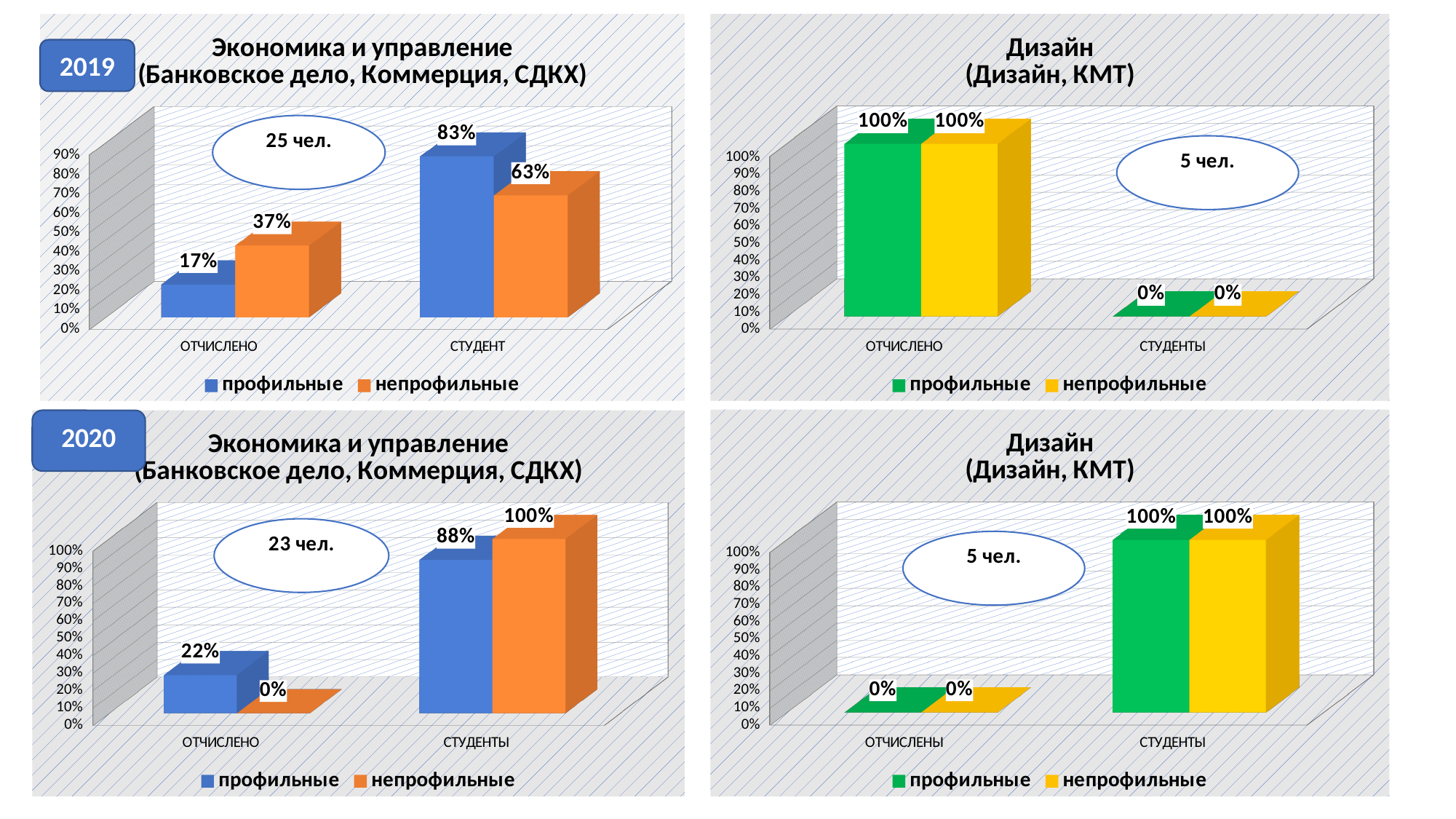
In the bottom-left chart (2020, Экономика и управление), what is the value for непрофильные in the ОТЧИСЛЕНО category? 0% In the bottom-left chart (2020, Экономика и управление), what is the difference between the непрофильные and профильные values for СТУДЕНТЫ? 12% In the top-left chart (2019, Экономика и управление), what is the value for непрофильные in the СТУДЕНТ category? 63% How many series does the legend of the bottom-right chart (2020, Дизайн) list? 2 In the top-right chart (2019, Дизайн), what is the value for профильные in the СТУДЕНТЫ category? 0% In the top-left chart (2019, Экономика и управление), which series has the larger value in the СТУДЕНТ category? профильные In the top-left chart (2019, Экономика и управление), what is the difference between the профильные and непрофильные values for ОТЧИСЛЕНО? 20% In the bottom-left chart (2020, Экономика и управление), which series has the larger value in the ОТЧИСЛЕНО category? профильные In the bottom-right chart (2020, Дизайн), what is the value for профильные in the СТУДЕНТЫ category? 100% In the top-left chart (2019, Экономика и управление), what is the value for профильные in the ОТЧИСЛЕНО category? 17% In the top-right chart (2019, Дизайн), what is the value for непрофильные in the ОТЧИСЛЕНО category? 100% What type of chart is the top-left chart (2019, Экономика и управление)? Bar chart